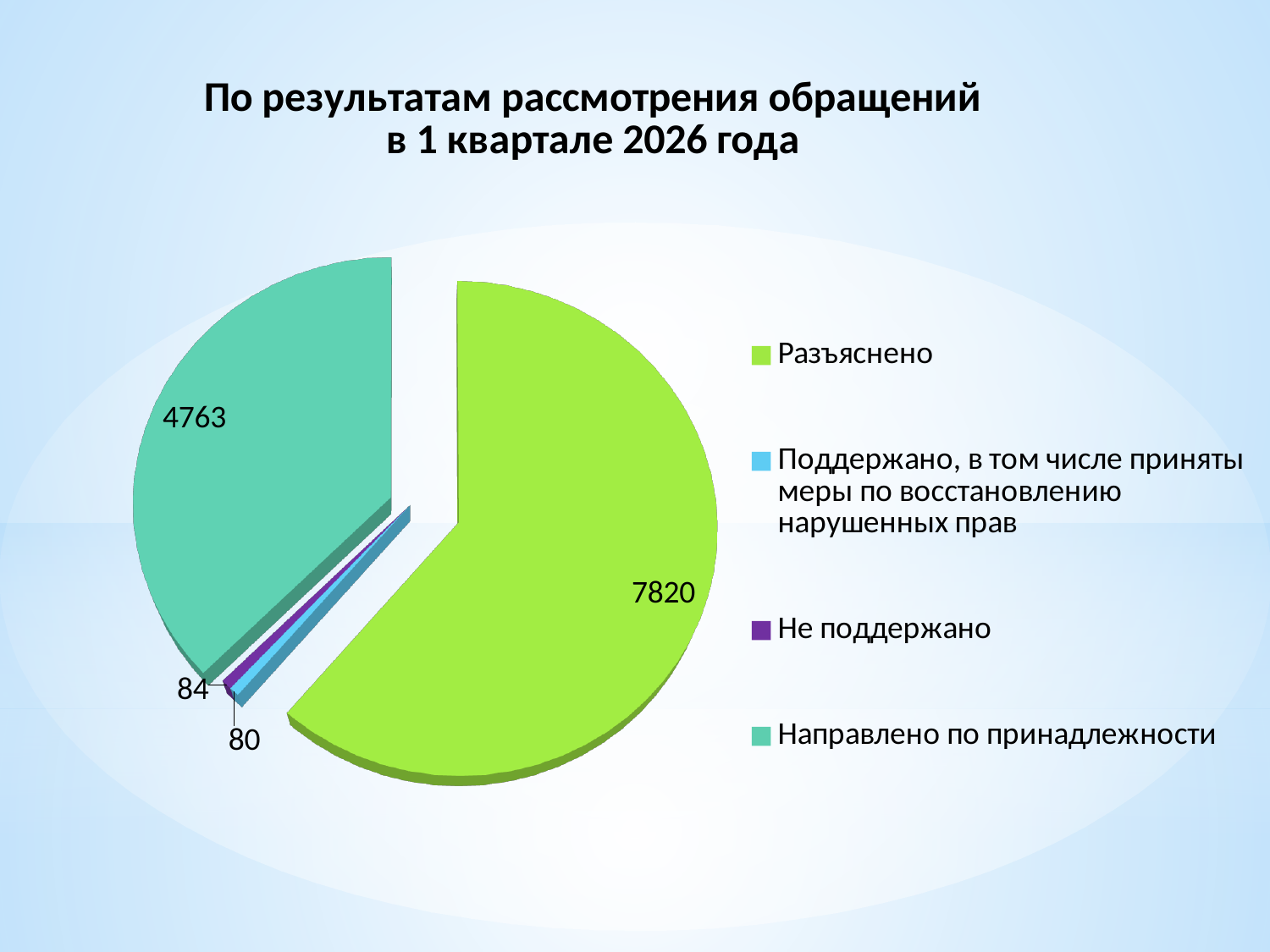
What type of chart is shown on the slide? pie chart Which is larger, the value for Разъяснено or the value for Направлено по принадлежности? Разъяснено How many categories does the pie chart have? 4 What is the value for Не поддержано? 84 What is the value for Разъяснено? 7820 What is the difference between the values for Разъяснено and Направлено по принадлежности? 3057 What is the title of the chart? По результатам рассмотрения обращений в 1 квартале 2026 года What is the value for Направлено по принадлежности? 4763 What is the total of all the values shown in the pie chart? 12747 Which category has the largest slice of the pie? Разъяснено Which category has the smallest value? Поддержано, в том числе приняты меры по восстановлению нарушенных прав What is the value for Поддержано, в том числе приняты меры по восстановлению нарушенных прав? 80